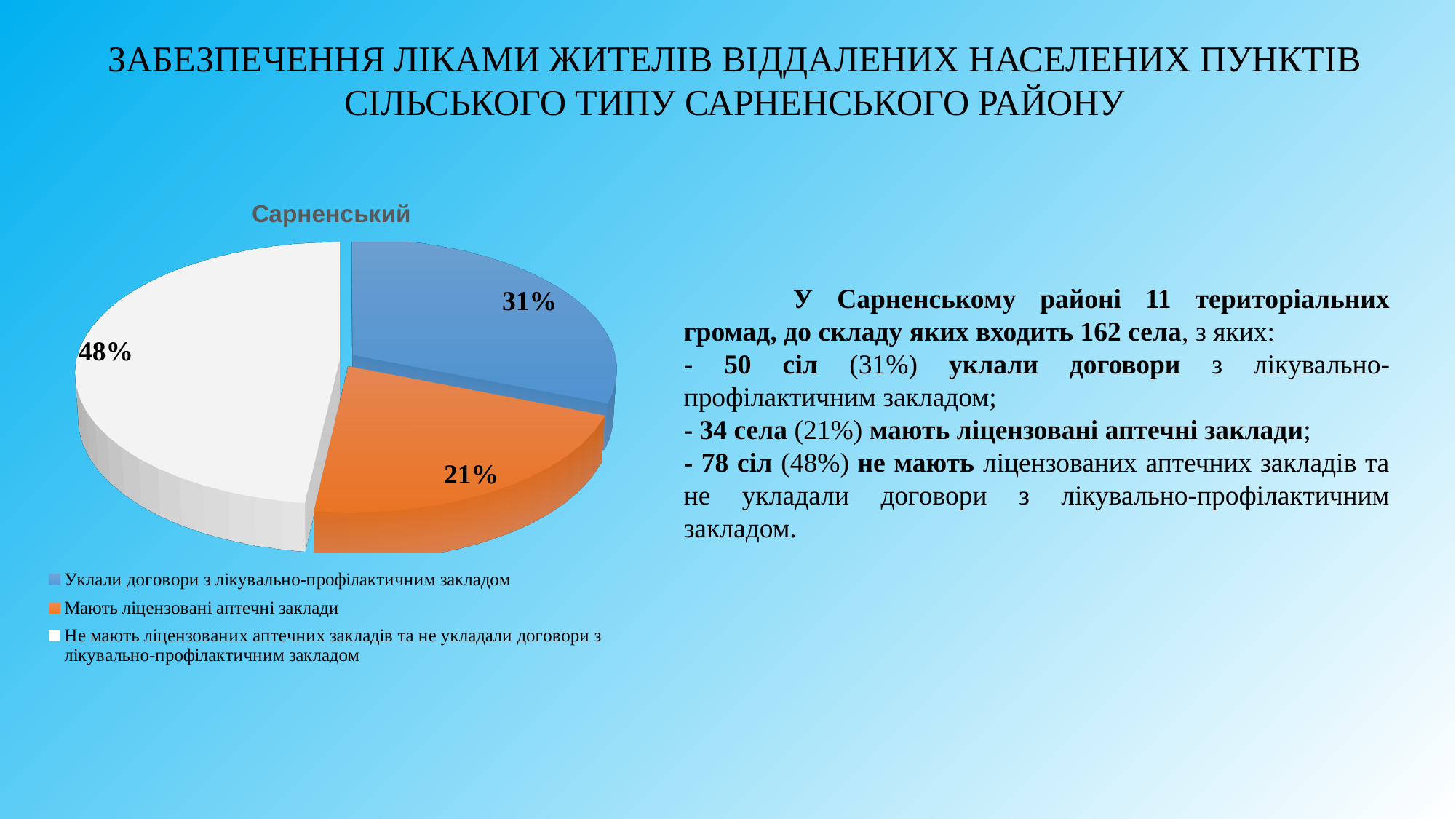
What share of the pie is labelled 'Уклали договори з лікувально-профілактичним закладом'? 31% What share of the pie is labelled 'Не мають ліцензованих аптечних закладів та не укладали договори з лікувально-профілактичним закладом'? 48% How many entries does the legend of the pie chart list? 3 Which category has the largest slice of the pie? Не мають ліцензованих аптечних закладів та не укладали договори з лікувально-профілактичним закладом What is the title of the pie chart? Сарненський What colour is the slice for 'Мають ліцензовані аптечні заклади'? Orange Which category has the smallest slice of the pie? Мають ліцензовані аптечні заклади What share of the pie is labelled 'Мають ліцензовані аптечні заклади'? 21% What kind of chart is shown on the slide? Pie chart What is the difference in percentage points between the 48% slice and the 31% slice? 17 Which is larger: the slice for 'Уклали договори з лікувально-профілактичним закладом' or the slice for 'Мають ліцензовані аптечні заклади'? Уклали договори з лікувально-профілактичним закладом How many slices does the pie chart have? 3